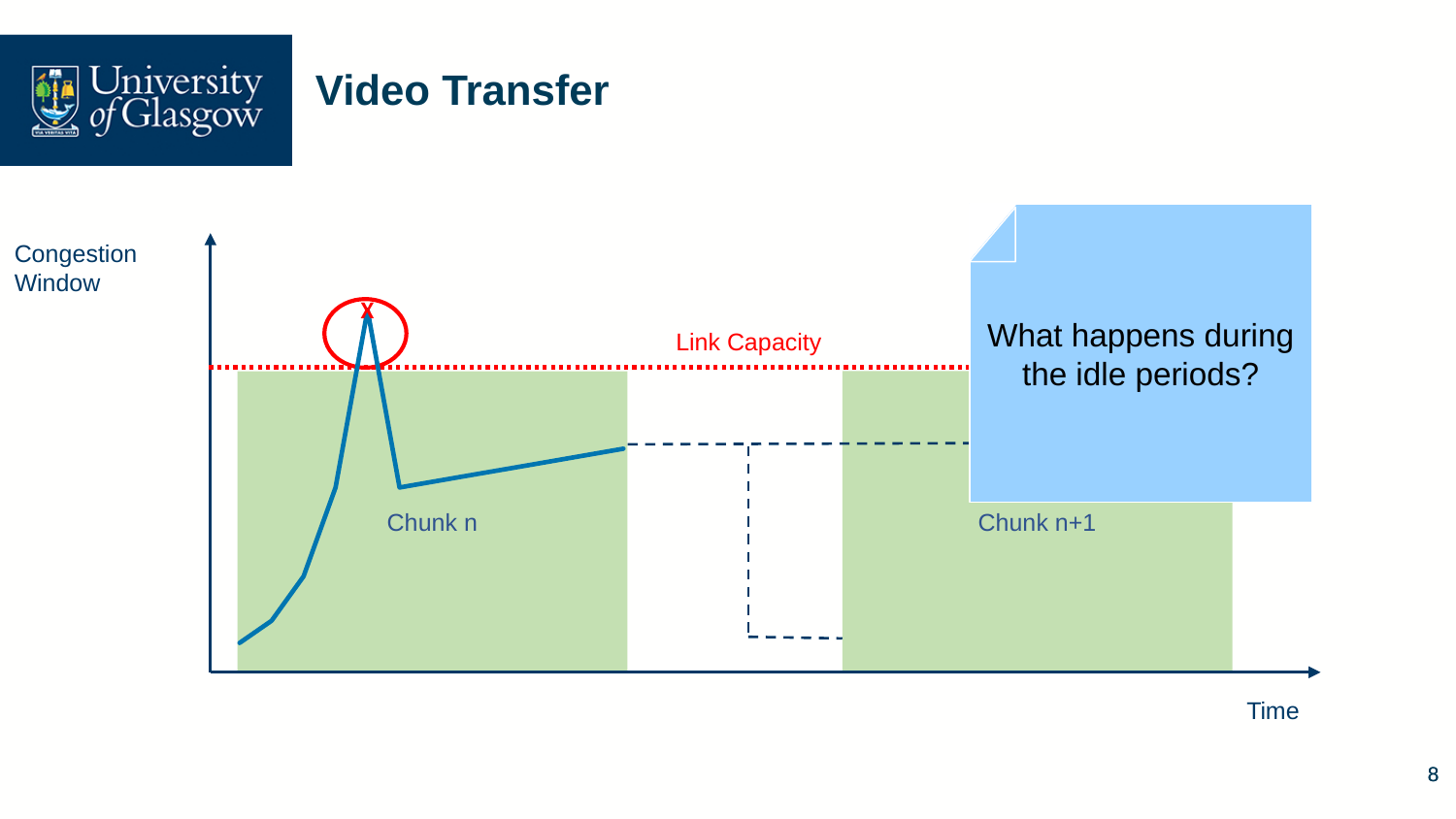
What is the title of the slide containing the chart? Video Transfer What is the label of the vertical axis? Congestion Window Does the congestion window rise or fall at the start of Chunk n? rise Immediately after the point marked with a red X, does the congestion window rise or fall? fall Which chunk comes first along the time axis, Chunk n or Chunk n+1? Chunk n Is the peak of the congestion window marked with the red X above or below the Link Capacity line? above How many chunks are labelled in the chart? 2 What does the red dotted horizontal line represent? Link Capacity What kind of chart is shown on the slide? line chart What is the label of the horizontal axis? Time